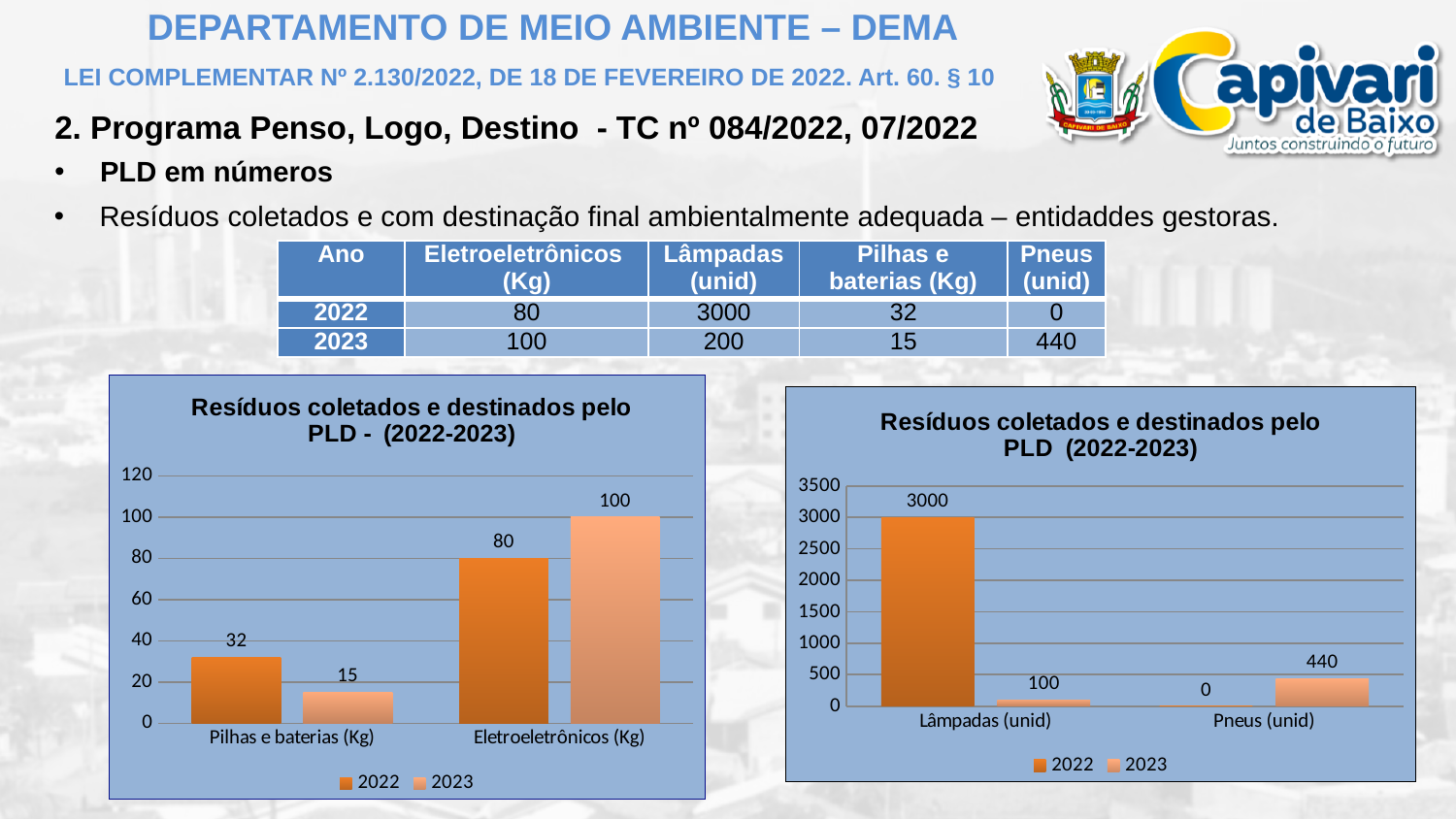
In the left chart, what is the value for Pilhas e baterias (Kg) in 2022? 32 In the right chart, what is the value for Lâmpadas (unid) in 2022? 3000 In the left chart, what is the difference between the 2022 and 2023 values for Pilhas e baterias (Kg)? 17 How many categories are shown on the x axis of the right chart? 2 In the left chart, which is larger for Eletroeletrônicos (Kg): the 2022 value or the 2023 value? 2023 In the right chart, what is the value for Pneus (unid) in 2023? 440 What kind of chart is the left chart? Bar chart In the right chart, what is the difference between the 2022 and 2023 values for Lâmpadas (unid)? 2900 In the right chart, which category and year has the lowest value? Pneus (unid), 2022 In the left chart, what is the value for Eletroeletrônicos (Kg) in 2023? 100 How many series does the legend of the right chart list? 2 In the left chart, which category and year has the highest value? Eletroeletrônicos (Kg), 2023